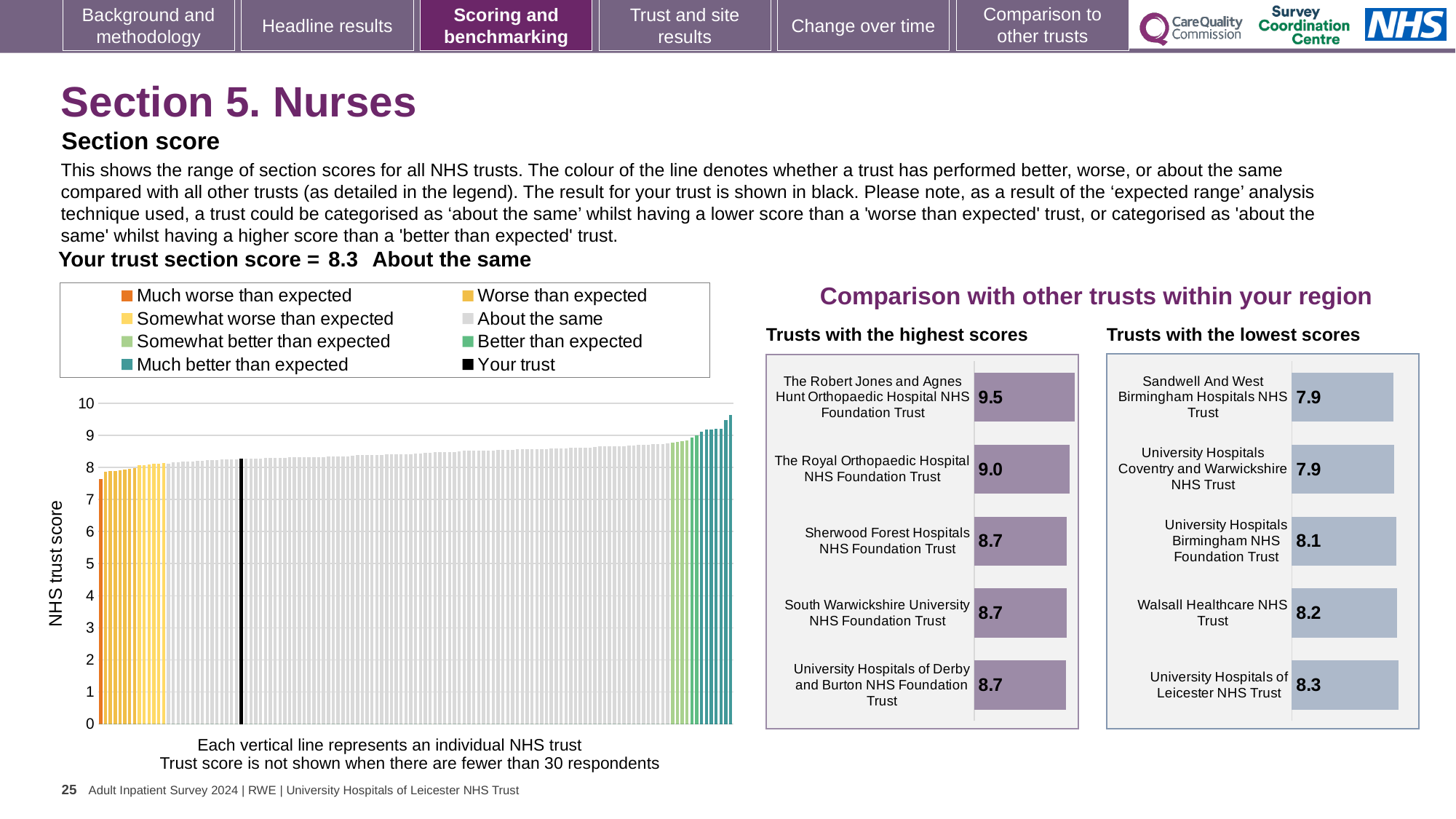
In the 'Trusts with the highest scores' chart, what is the score for The Royal Orthopaedic Hospital NHS Foundation Trust? 9.0 What kind of chart is the 'NHS trust score' chart on the left of the slide? Bar chart In the 'Trusts with the lowest scores' chart, what is the score for University Hospitals of Leicester NHS Trust? 8.3 In the 'Trusts with the highest scores' chart, which trust has the highest score? The Robert Jones and Agnes Hunt Orthopaedic Hospital NHS Foundation Trust In the 'Trusts with the highest scores' chart, what is the difference between the scores of The Robert Jones and Agnes Hunt Orthopaedic Hospital NHS Foundation Trust and The Royal Orthopaedic Hospital NHS Foundation Trust? 0.5 In the 'Trusts with the lowest scores' chart, what is the score for Walsall Healthcare NHS Trust? 8.2 In the 'Trusts with the lowest scores' chart, which trust has the highest score? University Hospitals of Leicester NHS Trust In the 'Trusts with the lowest scores' chart, what is the difference between the scores of University Hospitals of Leicester NHS Trust and Sandwell And West Birmingham Hospitals NHS Trust? 0.4 In the 'Trusts with the highest scores' chart, what is the score for The Robert Jones and Agnes Hunt Orthopaedic Hospital NHS Foundation Trust? 9.5 How many trusts are listed in the 'Trusts with the highest scores' chart? 5 How many entries does the legend of the 'NHS trust score' chart on the left list? 8 In the 'Trusts with the lowest scores' chart, which has the larger score: University Hospitals Birmingham NHS Foundation Trust or Walsall Healthcare NHS Trust? Walsall Healthcare NHS Trust